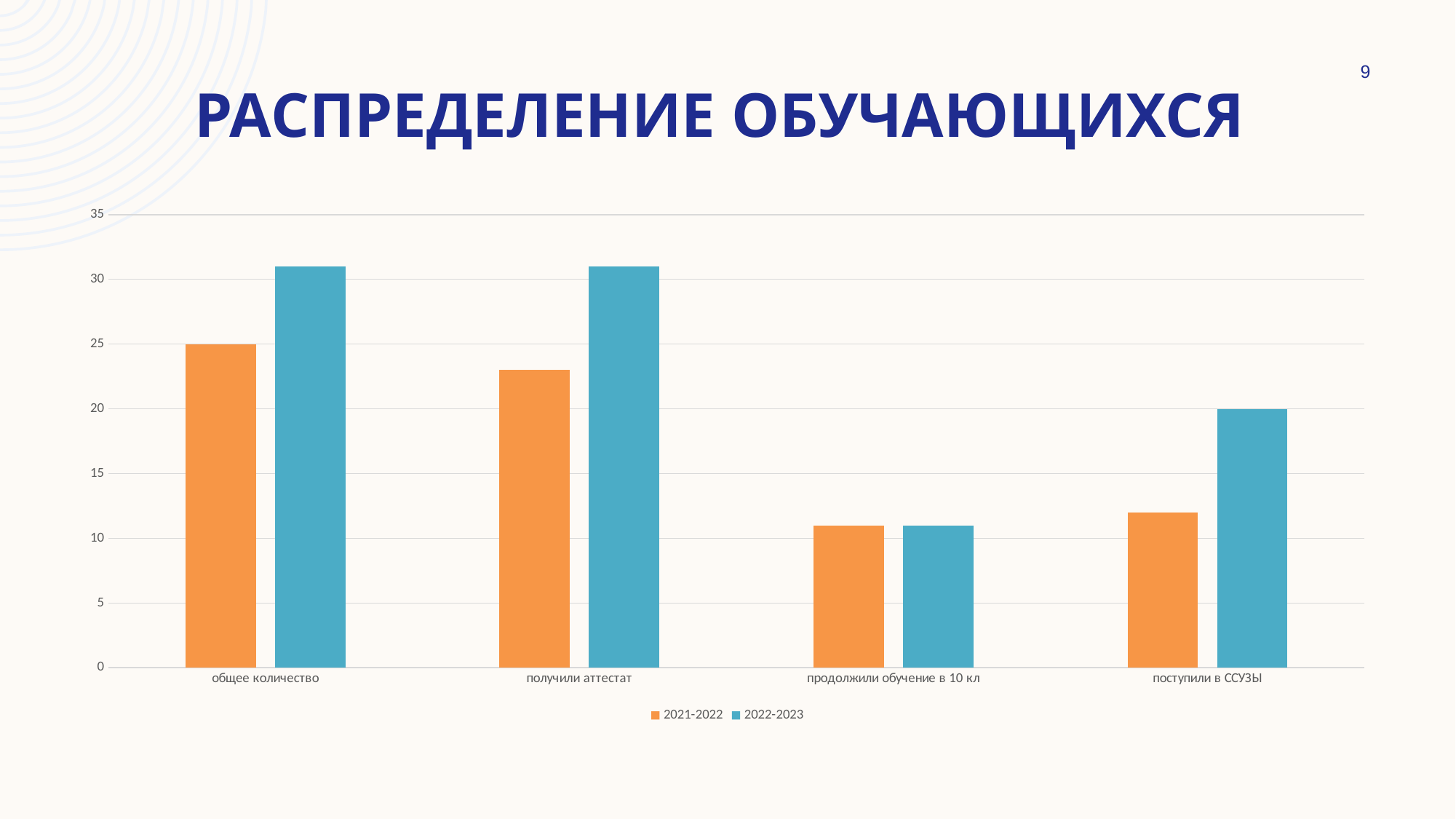
What is the value for общее количество in the 2021-2022 series? 25 What is the value for поступили в ССУЗЫ in the 2022-2023 series? 20 How many categories are shown on the x axis of the chart? 4 For поступили в ССУЗЫ, which series has the larger value, 2021-2022 or 2022-2023? 2022-2023 Is the value for получили аттестат in the 2021-2022 series greater or less than 20? greater Is the value for поступили в ССУЗЫ in the 2021-2022 series greater or less than 15? less Is the value for продолжили обучение в 10 кл in the 2022-2023 series greater or less than 15? less How many series does the chart legend list? 2 What type of chart is shown on the slide? Bar chart For общее количество, which series has the larger value, 2021-2022 or 2022-2023? 2022-2023 What is the title of the slide containing the chart? РАСПРЕДЕЛЕНИЕ ОБУЧАЮЩИХСЯ